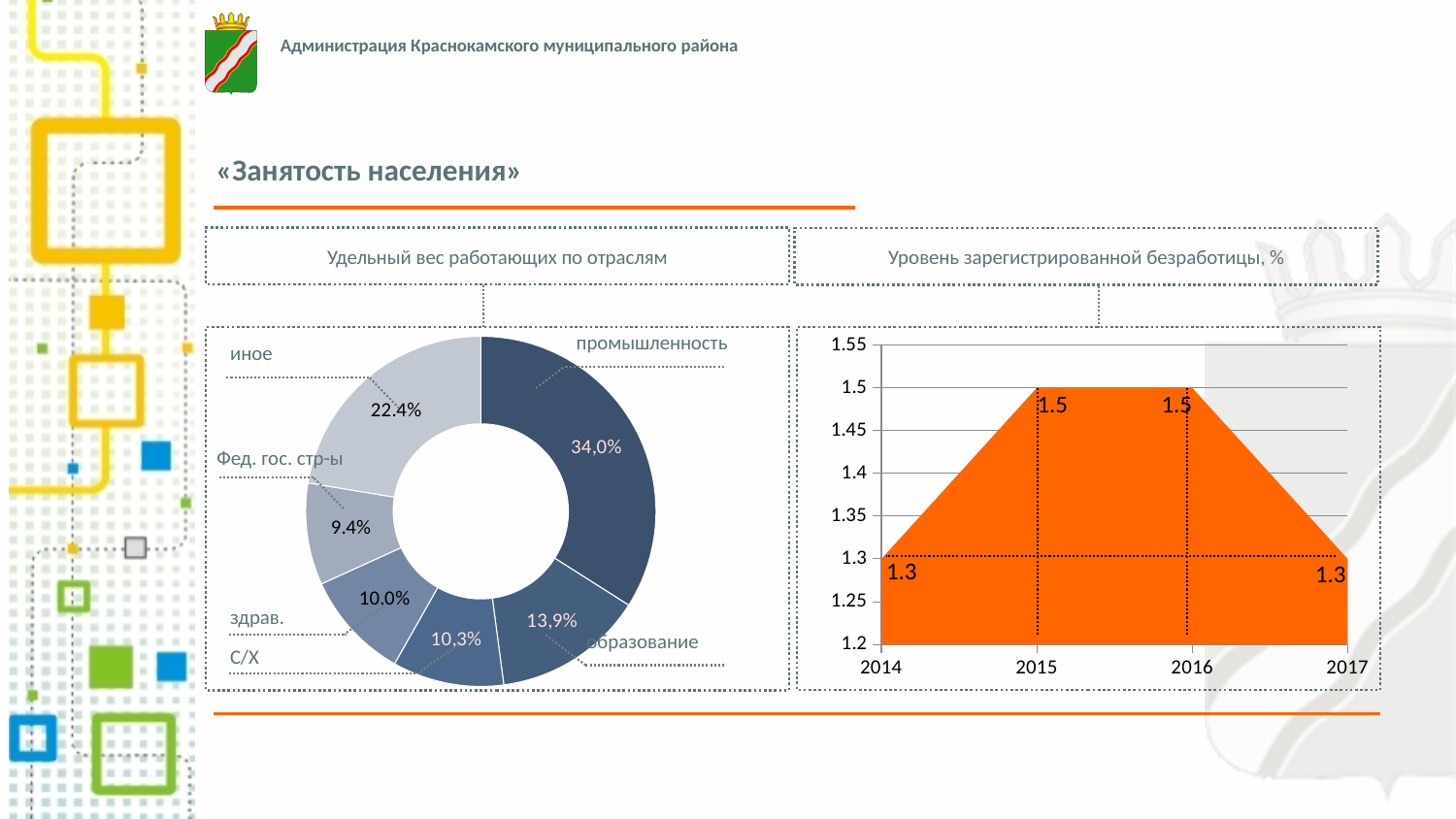
In the chart 'Уровень зарегистрированной безработицы, %', what is the value for 2017? 1.3 What kind of chart is 'Удельный вес работающих по отраслям'? Doughnut chart In the chart 'Удельный вес работающих по отраслям', which is larger: здрав. or С/Х? С/Х In the chart 'Удельный вес работающих по отраслям', how many sectors are shown? 6 In the chart 'Удельный вес работающих по отраслям', which sector has the largest share? промышленность In the chart 'Уровень зарегистрированной безработицы, %', what is the value for 2015? 1.5 In the chart 'Удельный вес работающих по отраслям', what is the share for иное? 22.4% In the chart 'Уровень зарегистрированной безработицы, %', what is the difference between the values for 2015 and 2014? 0.2 In the chart 'Удельный вес работающих по отраслям', what is the share for промышленность? 34,0% In the chart 'Удельный вес работающих по отраслям', which sector has the smallest share? Фед. гос. стр-ы In the chart 'Удельный вес работающих по отраслям', what is the share for образование? 13,9% In the chart 'Уровень зарегистрированной безработицы, %', how many years are shown on the x axis? 4